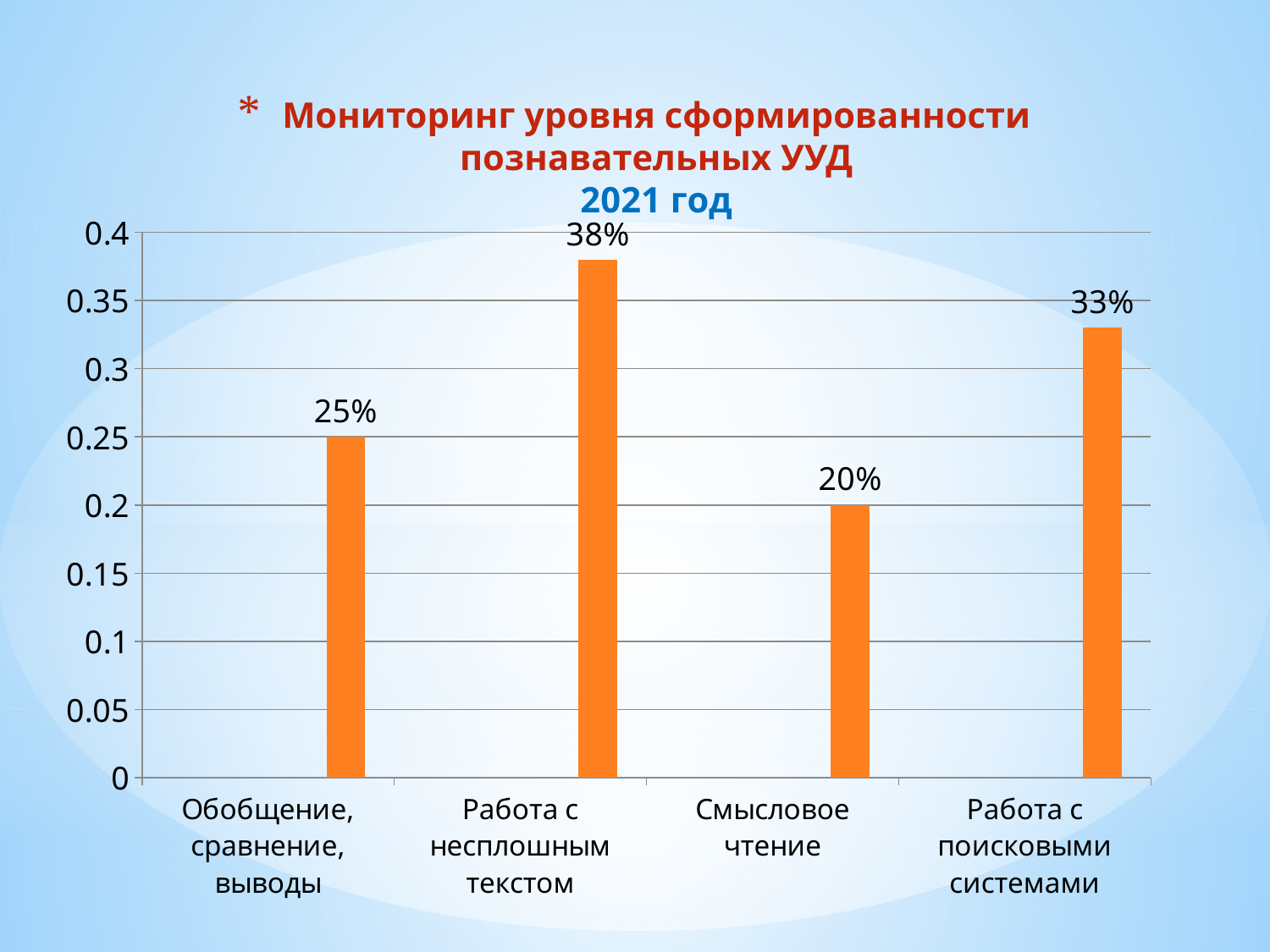
What year is shown in the chart title? 2021 год Which is larger: the value for Обобщение, сравнение, выводы or the value for Работа с поисковыми системами? Работа с поисковыми системами What is the value for Смысловое чтение? 20% Which category has the lowest value? Смысловое чтение What is the value for Обобщение, сравнение, выводы? 25% What is the difference between the values for Работа с поисковыми системами and Обобщение, сравнение, выводы? 8% What is the difference between the values for Работа с несплошным текстом and Смысловое чтение? 18% What kind of chart is shown on the slide? Bar chart What is the value for Работа с поисковыми системами? 33% How many categories are shown on the chart? 4 What is the value for Работа с несплошным текстом? 38% Which category has the highest value? Работа с несплошным текстом